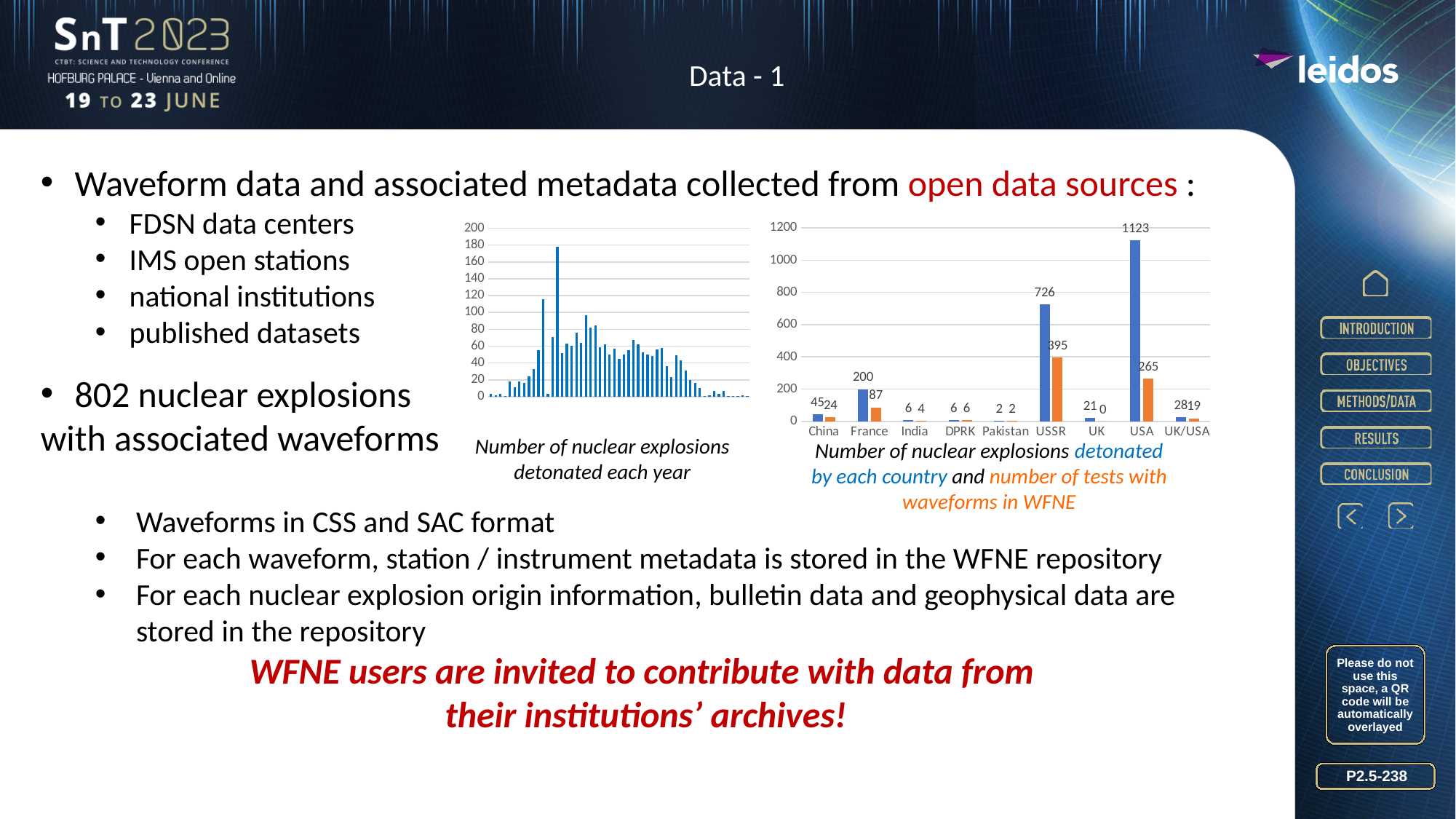
In the chart of nuclear explosions detonated by each country, what is the difference between the number of explosions detonated by the USA and the number of USA tests with waveforms in WFNE? 858 In the chart of nuclear explosions detonated each year, is the value of the tallest bar greater or less than 160? greater What kind of chart is the chart of nuclear explosions detonated each year? Bar chart In the chart of nuclear explosions detonated by each country, which country has the lowest number of nuclear explosions detonated? Pakistan How many countries (categories) are shown in the chart of nuclear explosions detonated by each country? 9 In the chart of nuclear explosions detonated by each country, which country has the highest number of nuclear explosions detonated? USA In the chart of nuclear explosions detonated by each country, how many tests with waveforms in WFNE are shown for the UK? 0 In the chart of nuclear explosions detonated by each country, which is larger: the number of tests with waveforms in WFNE for the USSR or for the USA? USSR In the chart of nuclear explosions detonated by each country, how many nuclear explosions were detonated by the USA? 1123 How many series are plotted in the chart of nuclear explosions detonated by each country? 2 In the chart of nuclear explosions detonated by each country, how many nuclear explosions were detonated by France? 200 In the chart of nuclear explosions detonated by each country, how many tests with waveforms in WFNE are shown for the USSR? 395